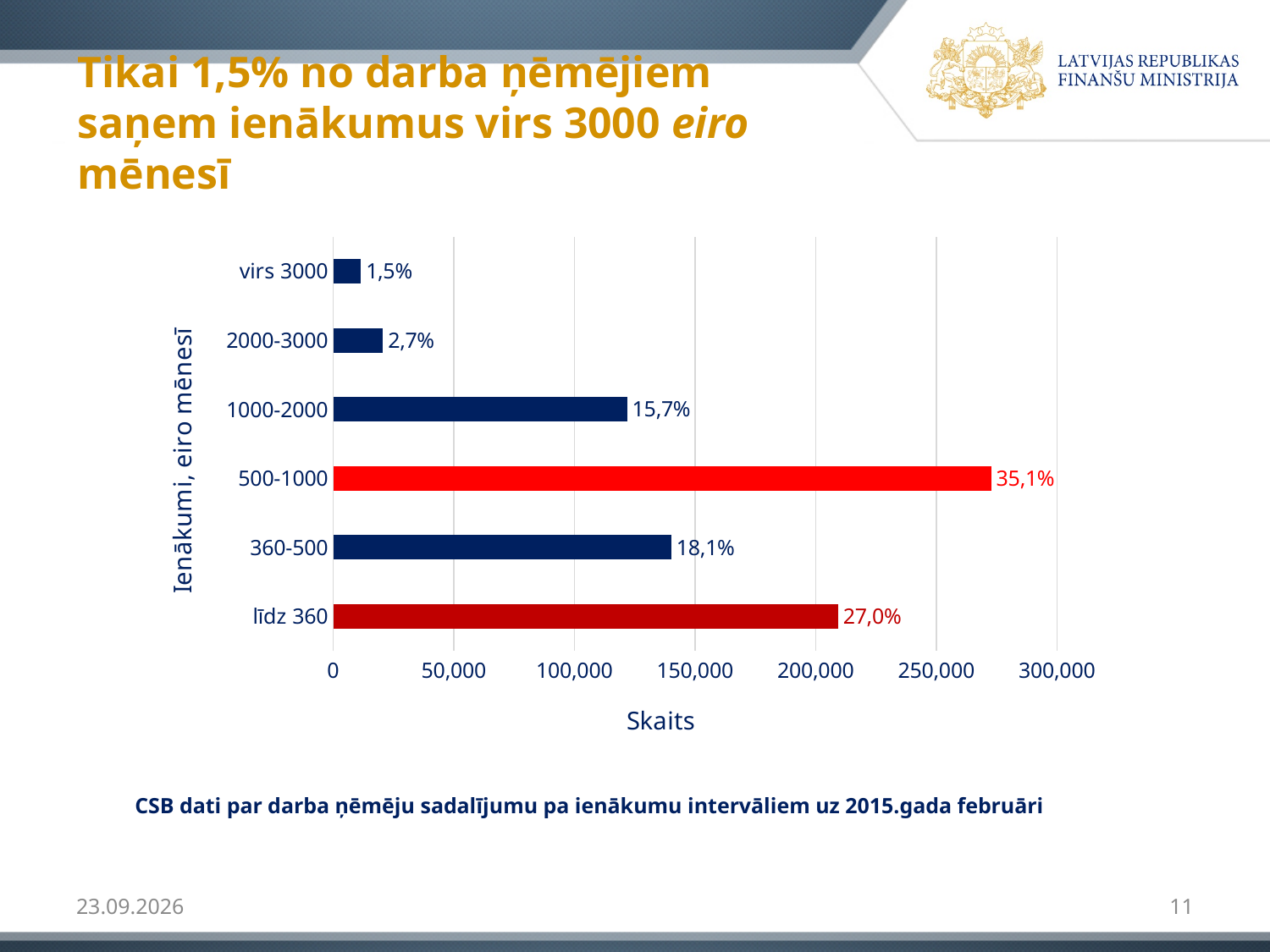
What percentage label is shown for the '1000-2000' income group? 15,7% What percentage label is shown for the '500-1000' income group? 35,1% What percentage label is shown for the 'virs 3000' income group? 1,5% Which income group has the smallest share of employees? virs 3000 How many income groups are shown in the chart? 6 Which income group has the largest share of employees? 500-1000 What is the difference in percentage points between the '500-1000' group and the 'līdz 360' group? 8,1% What percentage label is shown for the '360-500' income group? 18,1% Which group has a larger share: '360-500' or '1000-2000'? 360-500 Is the count (Skaits) for the '2000-3000' group greater or less than 50,000? less Is the count (Skaits) for the '500-1000' group greater or less than 250,000? greater What type of chart is shown on the slide? Bar chart